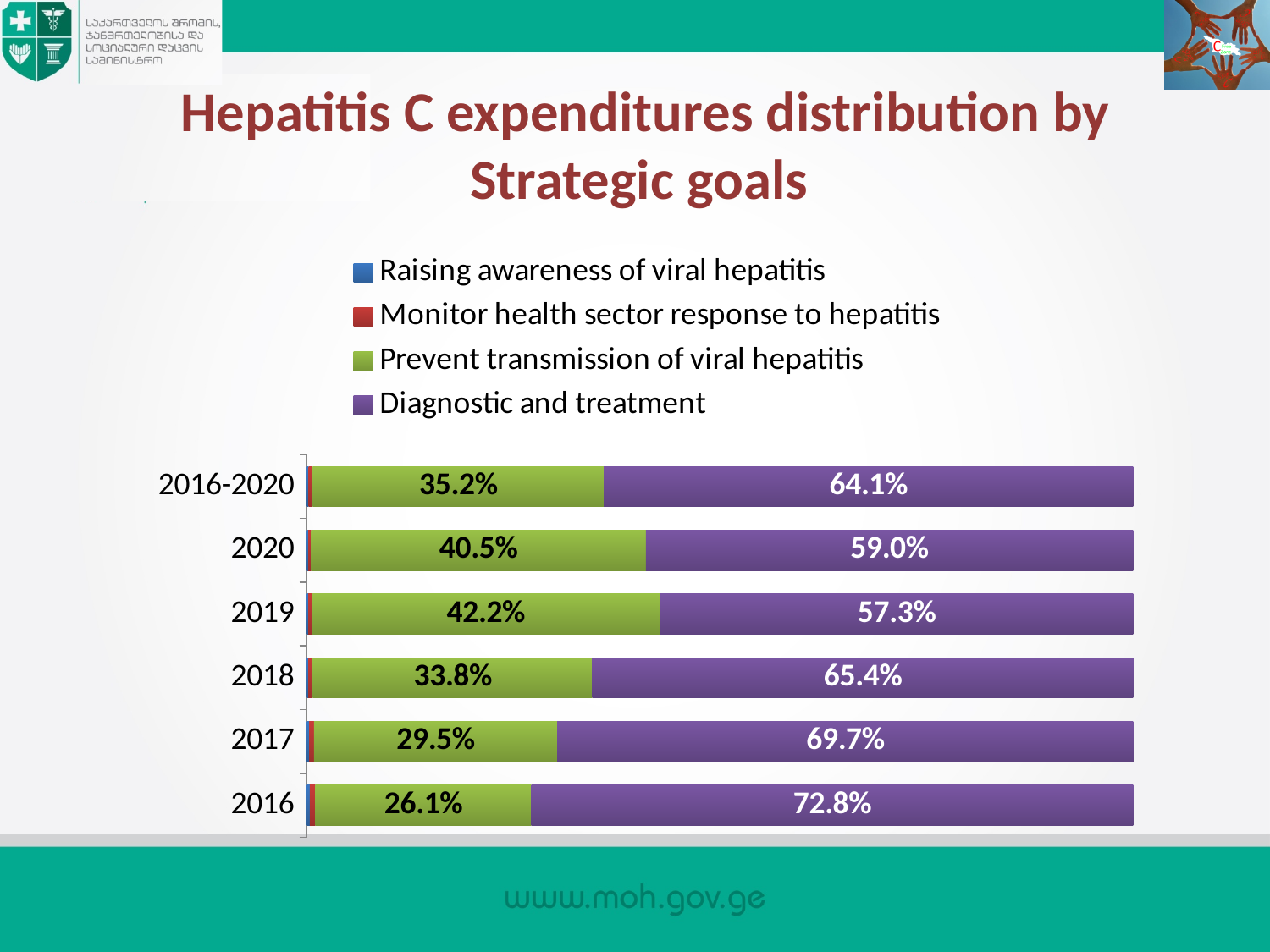
What is the value for Diagnostic and treatment for the 2016-2020 bar? 64.1% How many bars (categories) are shown on the chart? 6 What is the value for Diagnostic and treatment in 2016? 72.8% Which is larger: the Prevent transmission of viral hepatitis value in 2020 or in 2018? 2020 What is the value for Prevent transmission of viral hepatitis in 2019? 42.2% What is the value for Prevent transmission of viral hepatitis in 2020? 40.5% What is the difference between the Diagnostic and treatment value and the Prevent transmission of viral hepatitis value in 2016? 46.7 percentage points Which year has the highest value for Diagnostic and treatment? 2016 Which year has the lowest value for Prevent transmission of viral hepatitis? 2016 How many series does the legend list? 4 Does the Diagnostic and treatment share rise or fall from 2016 to 2019? Fall What kind of chart is shown on the slide? Stacked bar chart